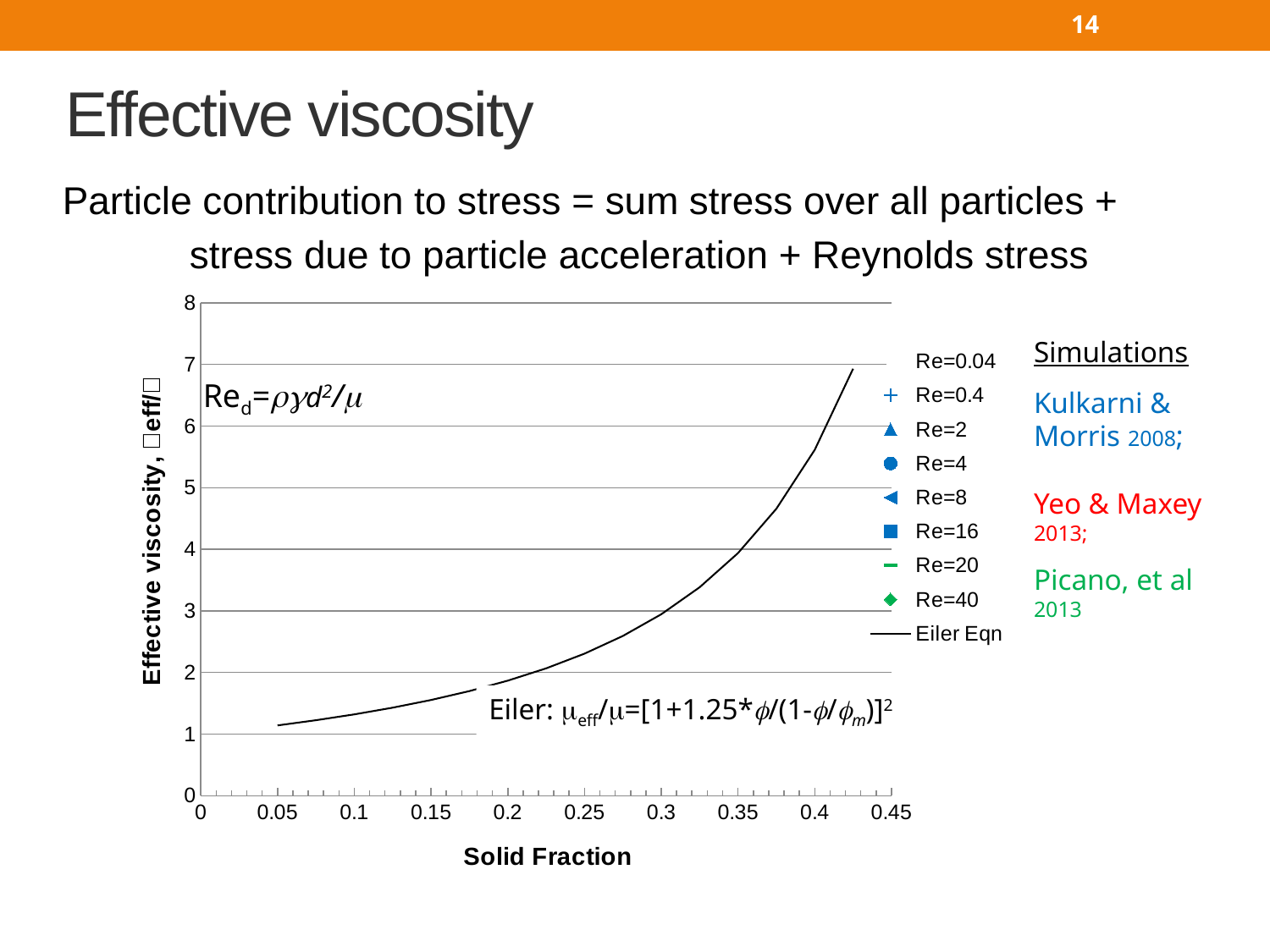
Does the Eiler Eqn curve rise or fall as the solid fraction increases? rises How many series does the chart legend list? 9 Is the value of the Eiler Eqn curve at a solid fraction of 0.2 greater or less than 3? less Is the value of the Eiler Eqn curve at a solid fraction of 0.1 greater or less than 2? less What kind of chart is shown on the slide? line chart What is the title of the x axis of the chart? Solid Fraction Is the value of the Eiler Eqn curve at a solid fraction of 0.05 greater or less than 1? greater Which legend entry corresponds to the solid black line in the chart? Eiler Eqn